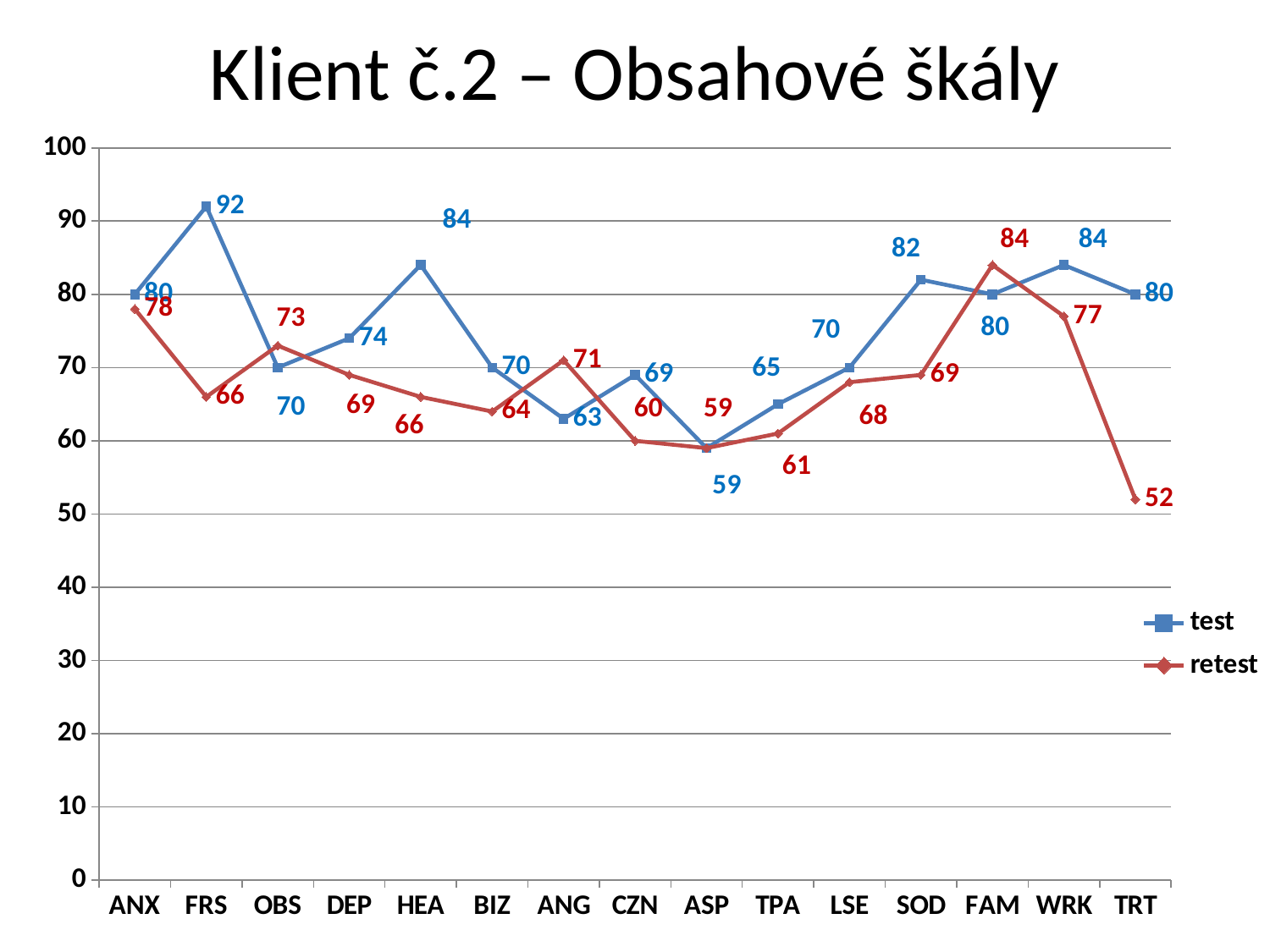
What kind of chart is shown on the slide? line chart Which is larger for ANG, the test value or the retest value? retest Which category has the lowest test value? ASP Which category has the lowest retest value? TRT What is the difference between the test and retest values for FRS? 26 What is the retest value for TRT? 52 What is the test value for FRS? 92 Which category has the highest test value? FRS Is the retest value for TRT greater or less than 60? less How many series does the legend list? 2 How many categories are shown on the x axis? 15 What is the retest value for FAM? 84